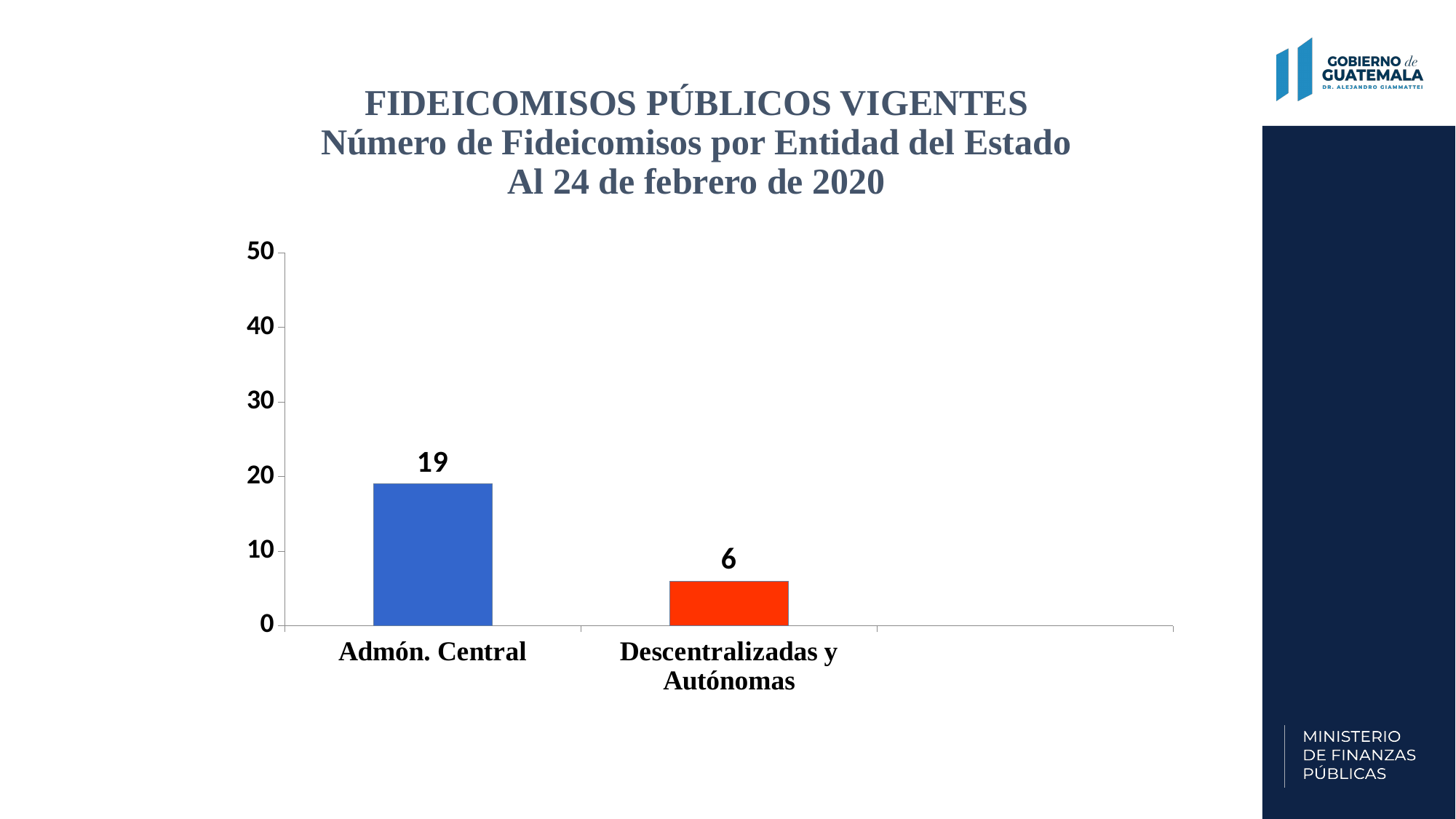
What is the maximum value shown on the vertical axis? 50 What kind of chart is shown on the slide? Bar chart What is the total of the two values shown on the chart? 25 What is the value for Descentralizadas y Autónomas? 6 Which is larger, the value for Admón. Central or the value for Descentralizadas y Autónomas? Admón. Central What is the value for Admón. Central? 19 Which category has the highest value? Admón. Central How many categories are shown on the chart? 2 Is the value for Descentralizadas y Autónomas greater or less than 10? less Which category has the lowest value? Descentralizadas y Autónomas What is the difference between the values for Admón. Central and Descentralizadas y Autónomas? 13 Is the value for Admón. Central greater or less than 10? greater